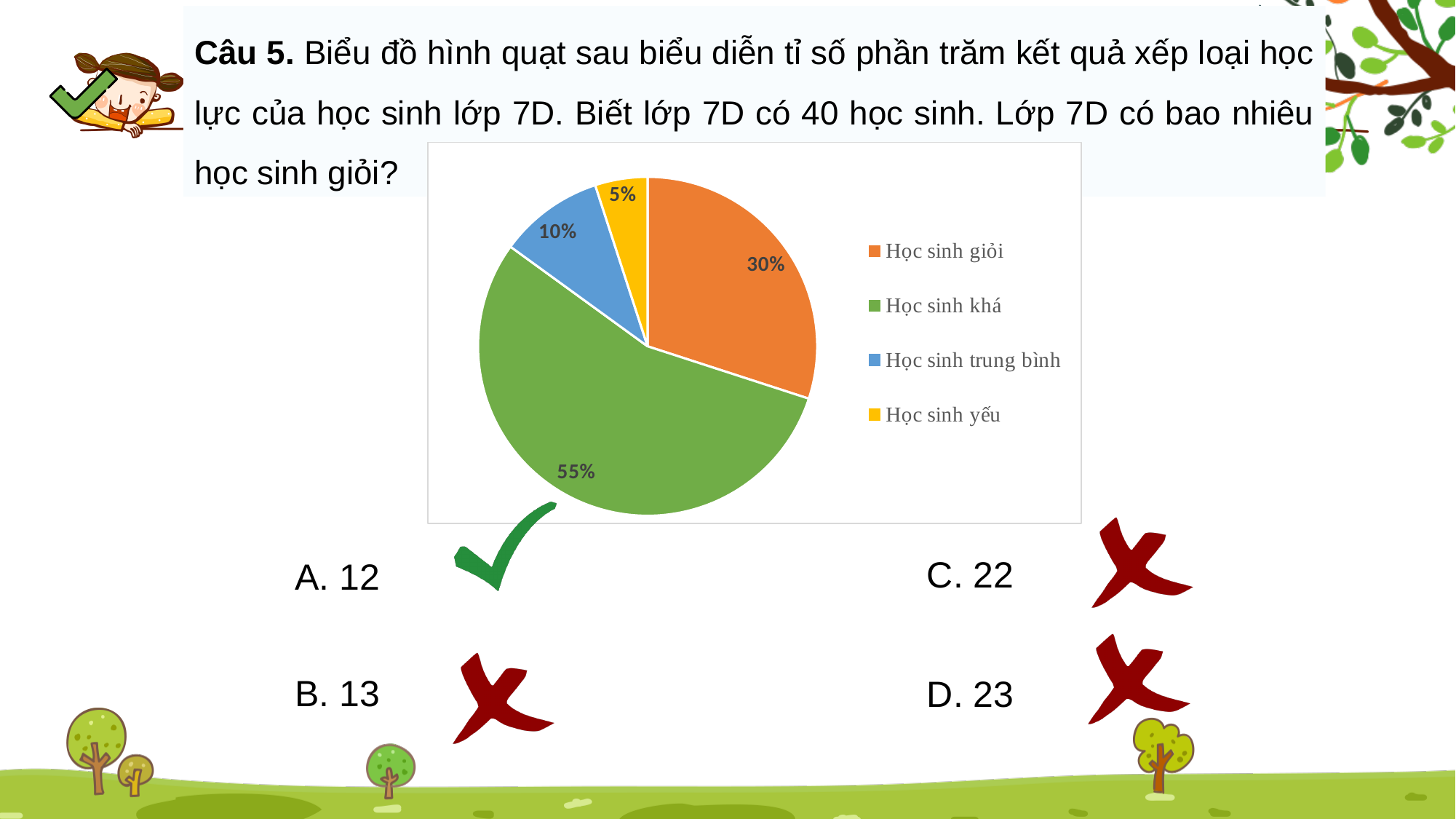
What is the difference in percentage points between Học sinh khá and Học sinh giỏi? 25% Which legend entry is shown in orange? Học sinh giỏi What percentage of the pie is labelled for Học sinh giỏi? 30% What colour is the slice for Học sinh trung bình? blue What percentage of the pie is labelled for Học sinh khá? 55% What kind of chart is shown on the slide? pie chart How many categories does the pie chart show? 4 Which category has the largest slice of the pie? Học sinh khá Which category has the smallest slice of the pie? Học sinh yếu Which is larger, the slice for Học sinh giỏi or the slice for Học sinh trung bình? Học sinh giỏi What percentage of the pie is labelled for Học sinh trung bình? 10% What percentage of the pie is labelled for Học sinh yếu? 5%